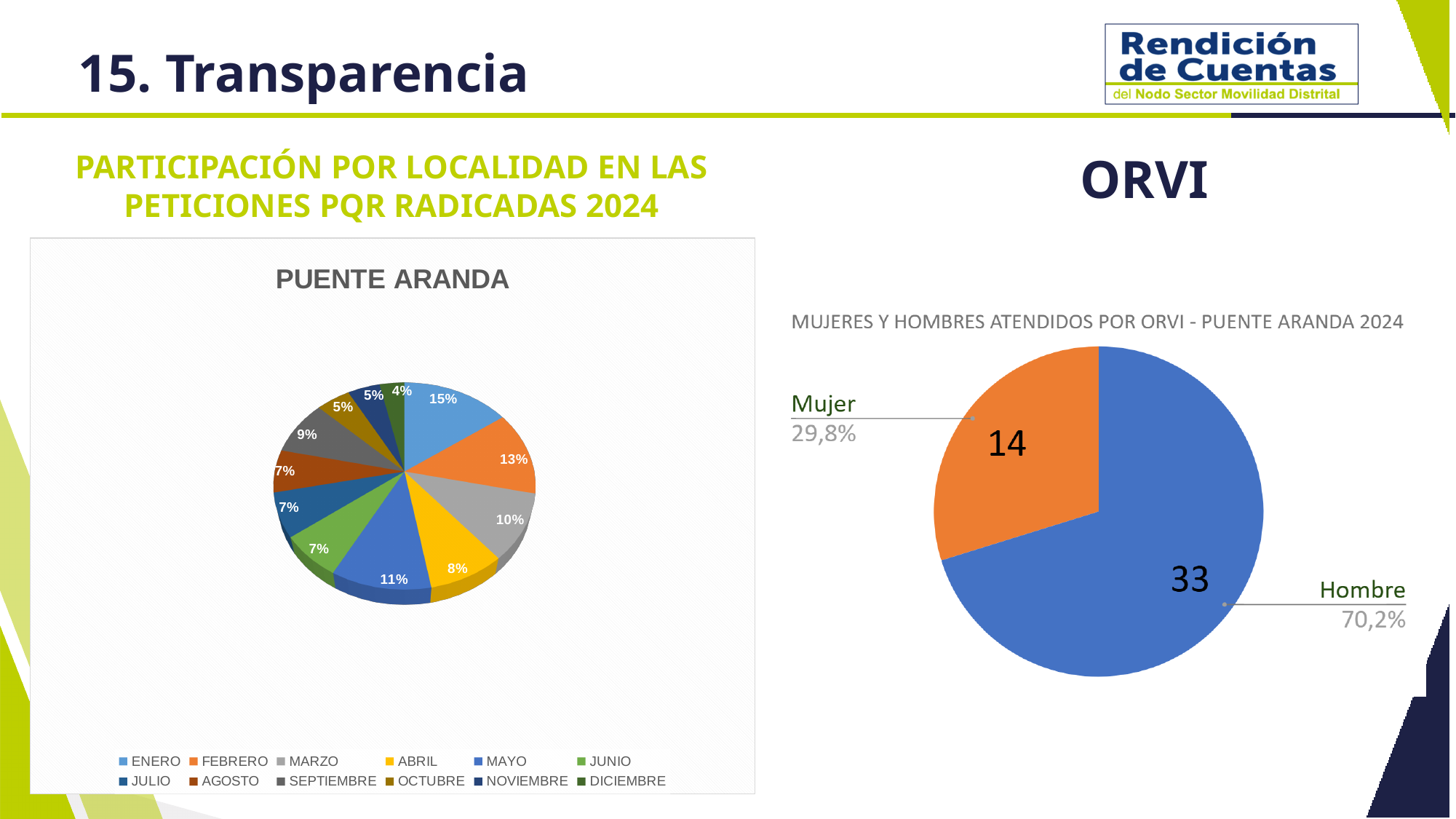
In the PUENTE ARANDA chart, what is the difference between the shares of FEBRERO and ABRIL? 5% In the ORVI chart, what is the total number of people attended (Mujer plus Hombre)? 47 What type of chart is the PUENTE ARANDA chart? Pie chart In the PUENTE ARANDA chart, which month has the largest share? ENERO In the PUENTE ARANDA chart, which month has the smallest share? DICIEMBRE In the PUENTE ARANDA chart, what percentage does MAYO represent? 11% In the PUENTE ARANDA chart, which has a larger share, MARZO or SEPTIEMBRE? MARZO In the ORVI chart, what percentage share does Mujer represent? 29,8% How many months (categories) does the PUENTE ARANDA pie chart show? 12 In the ORVI chart (MUJERES Y HOMBRES ATENDIDOS POR ORVI - PUENTE ARANDA 2024), how many Hombres were attended? 33 In the PUENTE ARANDA chart, what percentage does ENERO represent? 15% In the ORVI chart, what colour is the Hombre slice? Blue